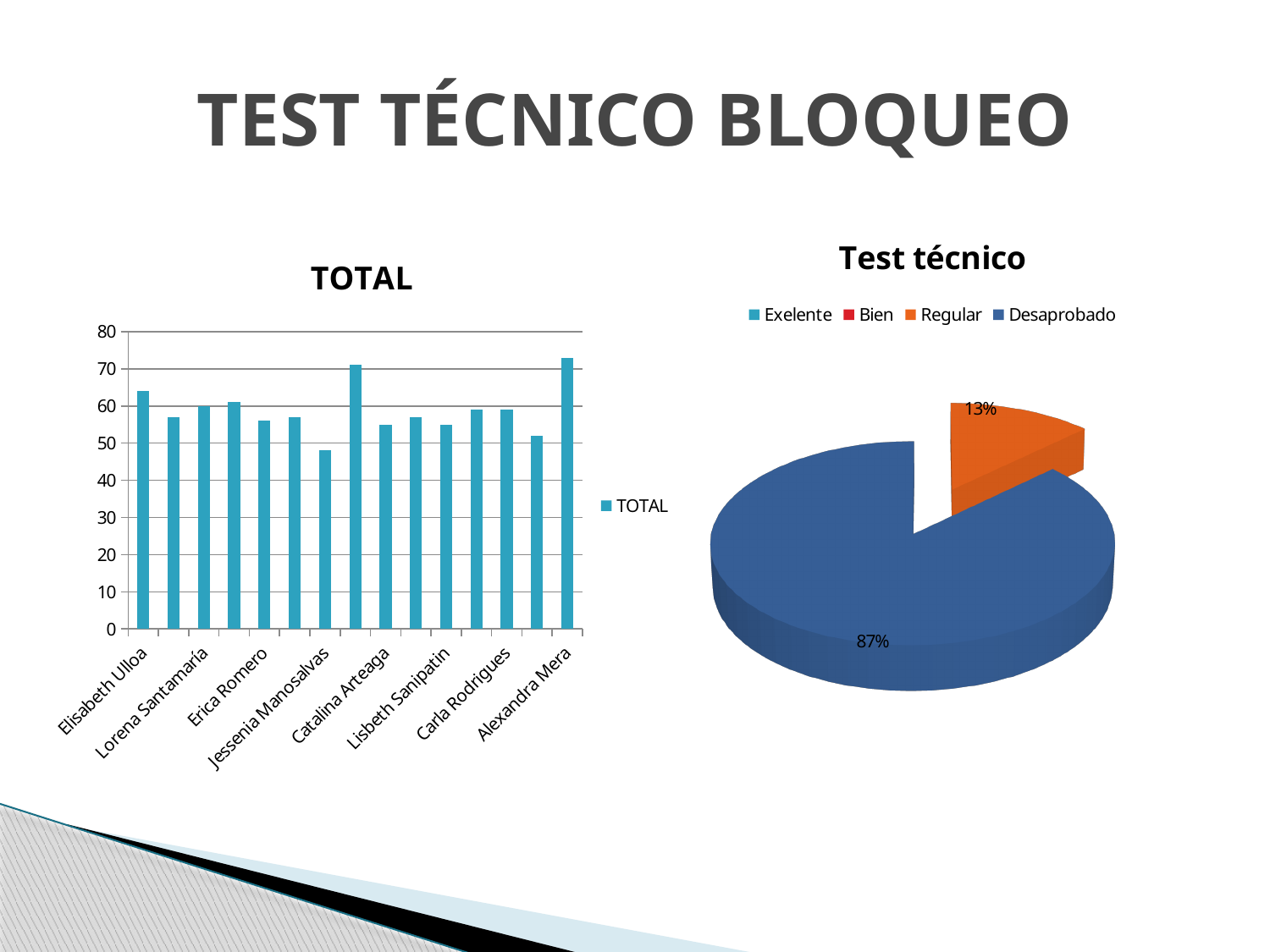
In the chart titled "Test técnico", how many entries does the legend list? 4 In the chart titled "Test técnico", what colour is the Desaprobado slice? blue In the chart titled "Test técnico", which category has the largest slice? Desaprobado In the chart titled "TOTAL", how many series does the legend list? 1 In the chart titled "Test técnico", what share of the pie is Regular? 13% What kind of chart is the chart titled "TOTAL"? bar chart In the chart titled "TOTAL", is the value for Alexandra Mera greater or less than 70? greater In the chart titled "TOTAL", is the value for Jessenia Manosalvas greater or less than 60? less In the chart titled "Test técnico", what share of the pie is Desaprobado? 87% What kind of chart is the chart titled "Test técnico"? pie chart In the chart titled "TOTAL", how many bars are plotted? 15 In the chart titled "TOTAL", which is larger, the value for Elisabeth Ulloa or the value for Jessenia Manosalvas? Elisabeth Ulloa